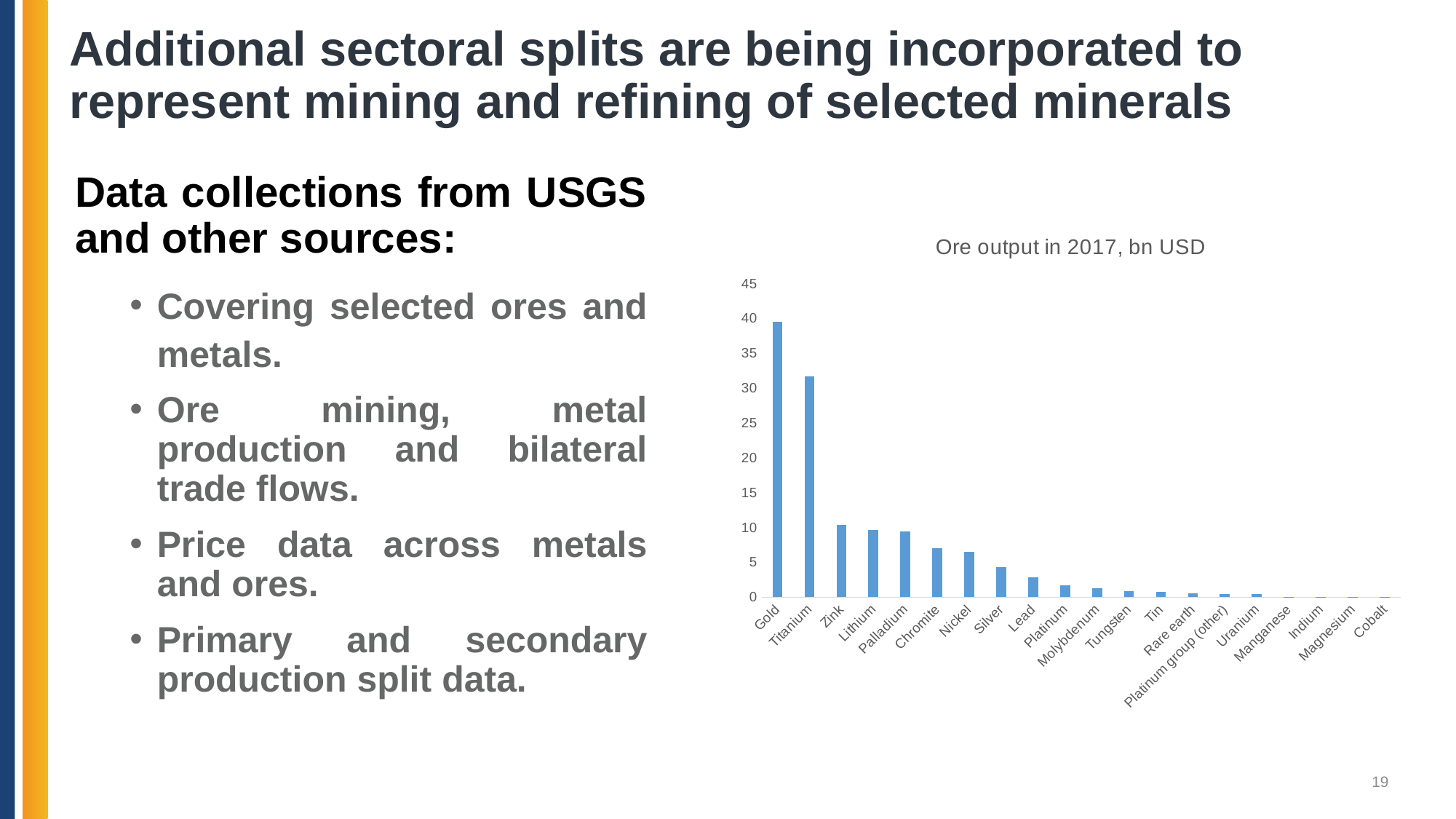
Is the value for Silver greater or less than 5? less How many categories are shown on the x axis of the chart? 20 Which is larger, the value for Zink or the value for Silver? Zink Which is larger, the value for Gold or the value for Titanium? Gold Is the value for Titanium greater or less than 30? greater Is the value for Chromite greater or less than 5? greater What is the title of the chart? Ore output in 2017, bn USD What kind of chart is shown on the slide? bar chart Which category has the highest ore output in the chart? Gold Do the values rise or fall moving from left to right along the x axis? fall